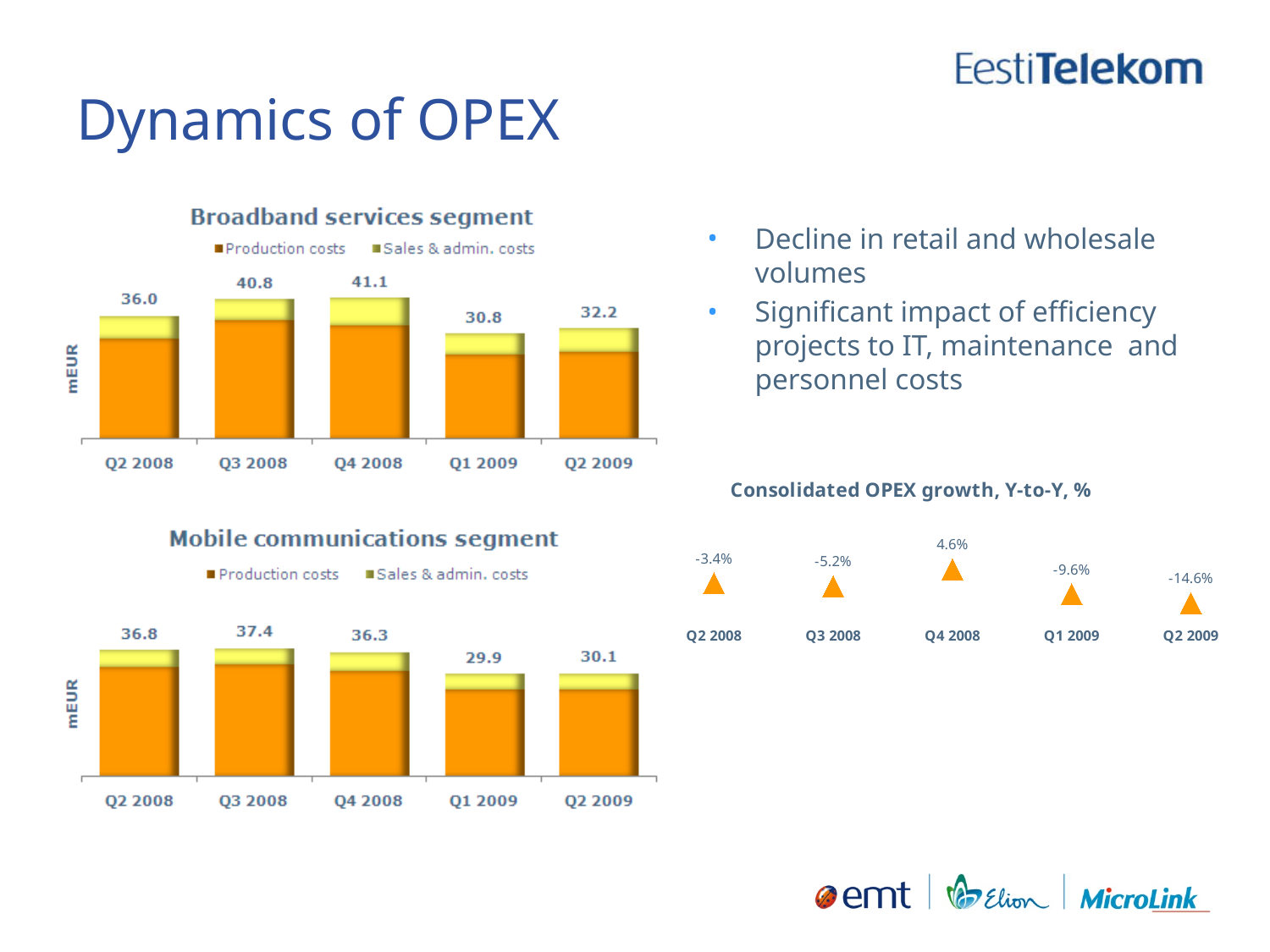
In the Broadband services segment chart, what is the difference between the totals for Q3 2008 and Q2 2009? 8.6 In the Consolidated OPEX growth, Y-to-Y, % chart, which quarter has the lowest value? Q2 2009 In the Mobile communications segment chart, is the total for Q1 2009 or Q2 2009 larger? Q2 2009 In the Broadband services segment chart, how many series does the legend list? 2 In the Mobile communications segment chart, what is the total shown for Q3 2008? 37.4 In the Broadband services segment chart, which quarter has the lowest total? Q1 2009 In the Broadband services segment chart, what is the total OPEX shown for Q4 2008? 41.1 What kind of chart is the Mobile communications segment chart? Stacked bar chart In the Consolidated OPEX growth, Y-to-Y, % chart, what is the value for Q4 2008? 4.6% In the Consolidated OPEX growth, Y-to-Y, % chart, do the values rise or fall from Q4 2008 to Q2 2009? Fall In the Mobile communications segment chart, how many quarters are plotted? 5 In the Mobile communications segment chart, which quarter has the highest total? Q3 2008